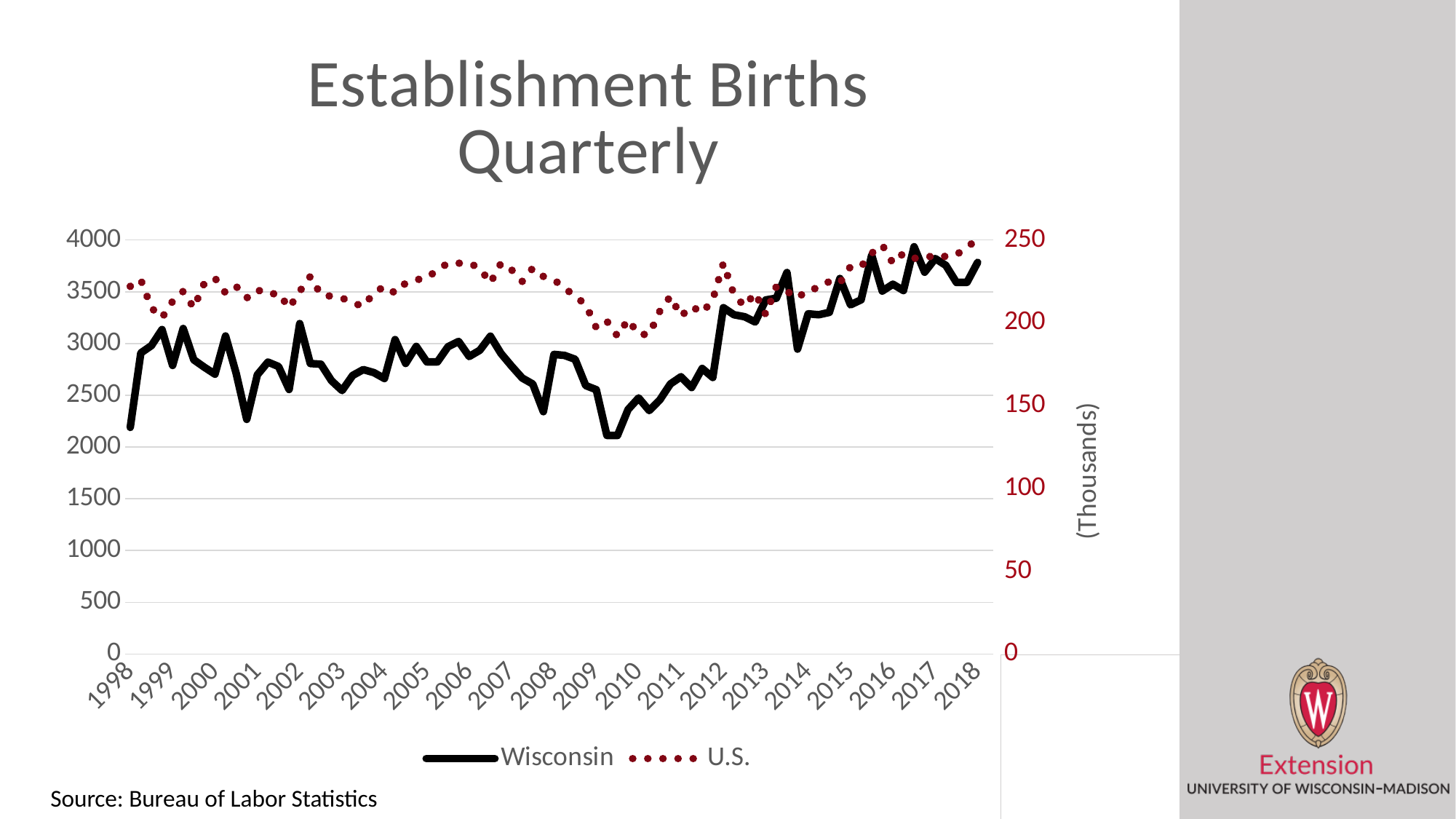
Is the lowest U.S. value, around 2010, greater or less than 200 on the right axis? less Is the Wisconsin value at the end of the series in 2018 greater or less than 3500? greater What is the title of the chart? Establishment Births Quarterly How many series does the legend list? 2 Is the U.S. value at the end of the series in 2018 greater or less than 200 on the right axis? greater Does the Wisconsin line generally rise or fall between 2007 and 2010? fall How many year labels are shown on the x axis? 21 Which is larger for Wisconsin: the value at the end of 2018 or the value at the start of 1998? end of 2018 Does the Wisconsin line generally rise or fall between 2010 and 2018? rise What type of chart is shown on the slide? line chart What are the two series named in the legend? Wisconsin and U.S.